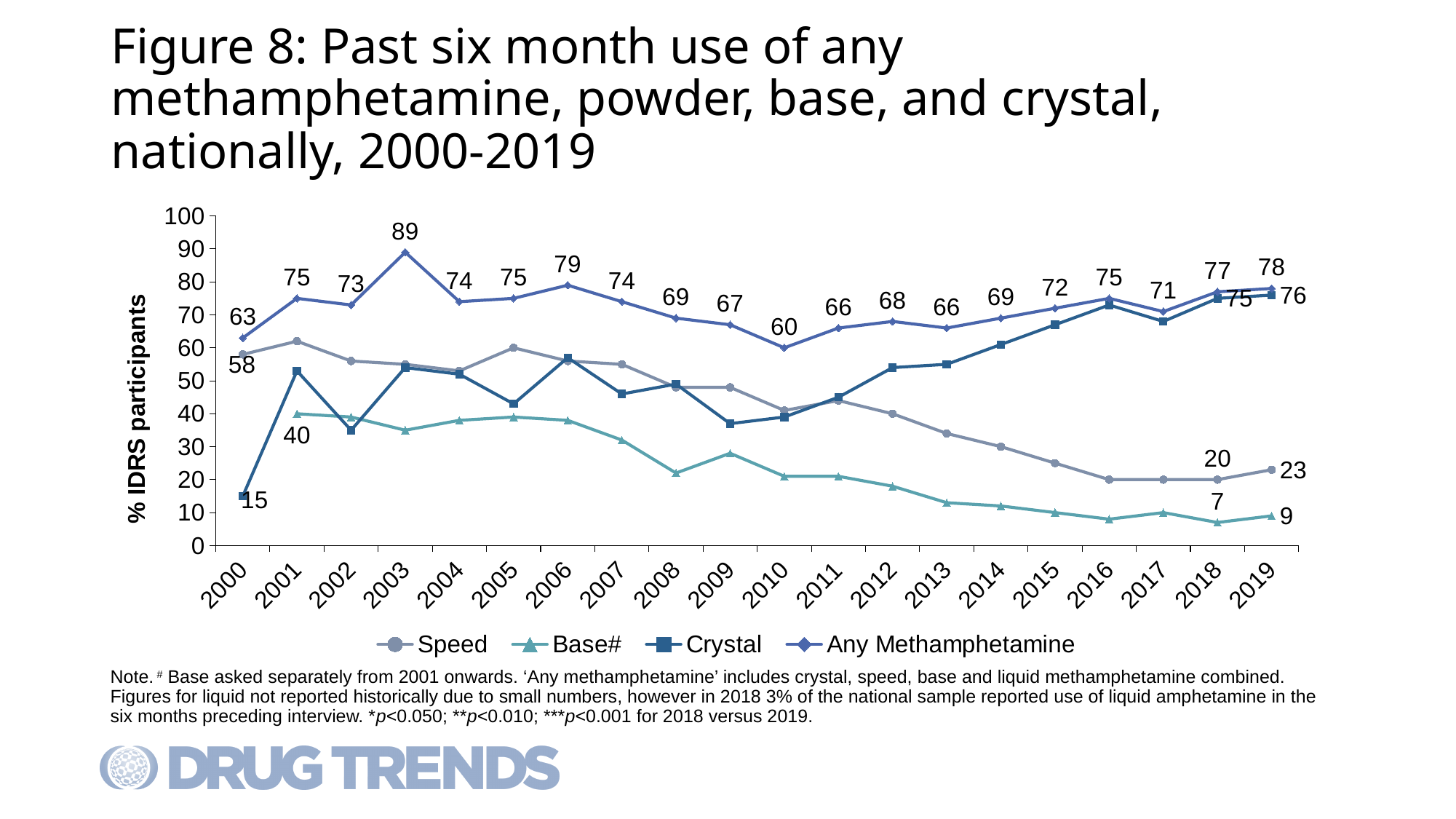
What was the value for Any Methamphetamine in 2003? 89 What was the value for Crystal in 2000? 15 By how much did the Crystal value in 2019 exceed its value in 2000? 61 In 2019, which was larger: the value for Speed or the value for Base#? Speed Does the Speed series rise or fall between 2005 and 2016? fall How many series does the legend list? 4 What kind of chart is shown on the slide? line chart In which year was the Any Methamphetamine value lowest? 2010 What was the value for Base# in 2019? 9 In which year was the Any Methamphetamine value highest? 2003 Is the value for Base# in 2008 greater or less than 30? less How many years are plotted along the x axis? 20